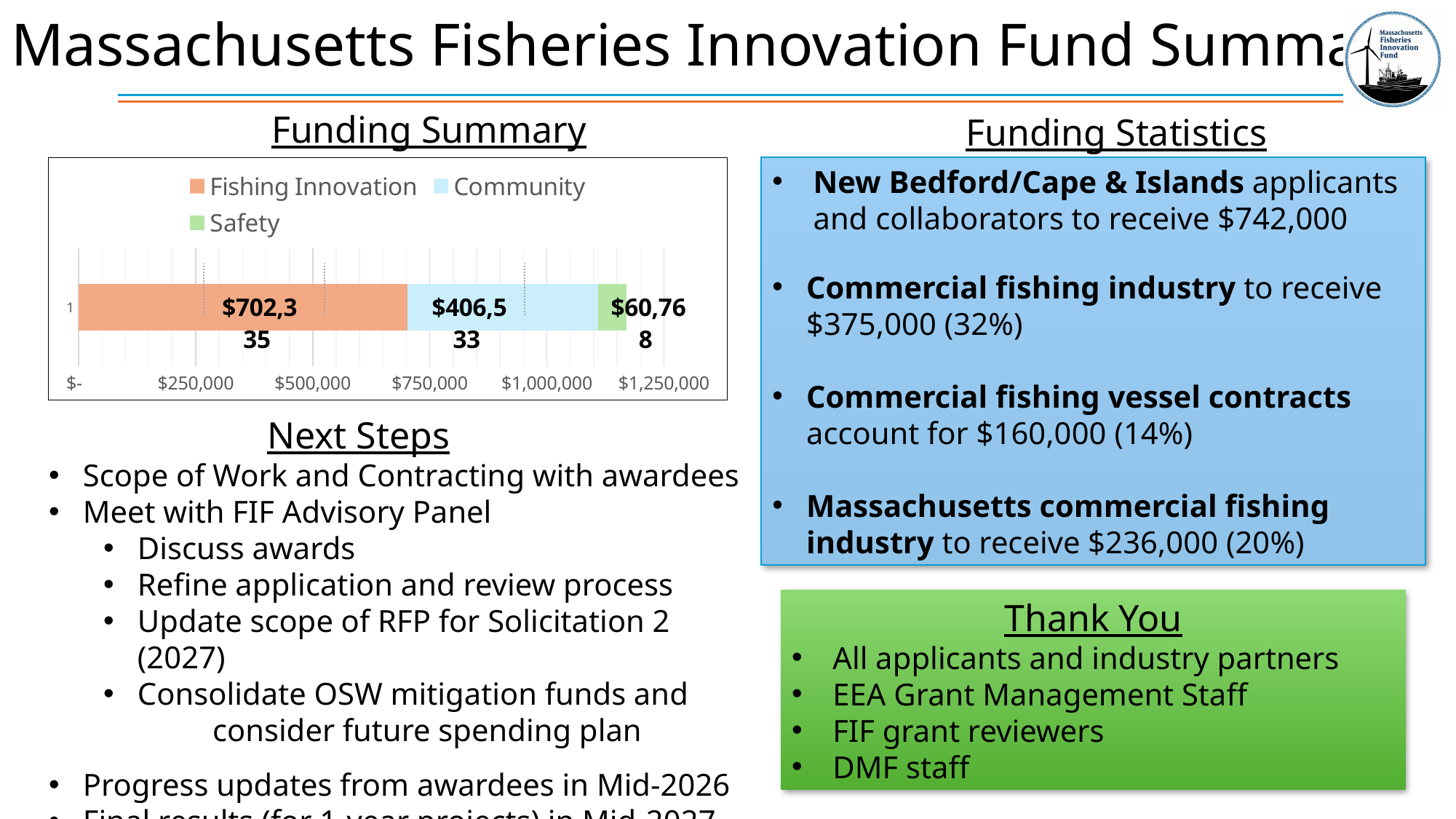
How many series does the legend of the Funding Summary chart list? 3 What is the value of the Fishing Innovation segment in the Funding Summary chart? $702,335 Which series has the largest value in the Funding Summary chart? Fishing Innovation What is the value of the Safety segment in the Funding Summary chart? $60,768 What is the total of the stacked bar in the Funding Summary chart? $1,169,636 In the Funding Summary chart, which is larger: Community or Safety? Community What type of chart is shown under Funding Summary? Stacked bar chart Is the total of the stacked bar in the Funding Summary chart greater or less than $1,250,000? less Which series has the smallest value in the Funding Summary chart? Safety Which series is shown in orange in the Funding Summary chart? Fishing Innovation What is the value of the Community segment in the Funding Summary chart? $406,533 What is the difference between the Fishing Innovation and Community values in the Funding Summary chart? $295,802